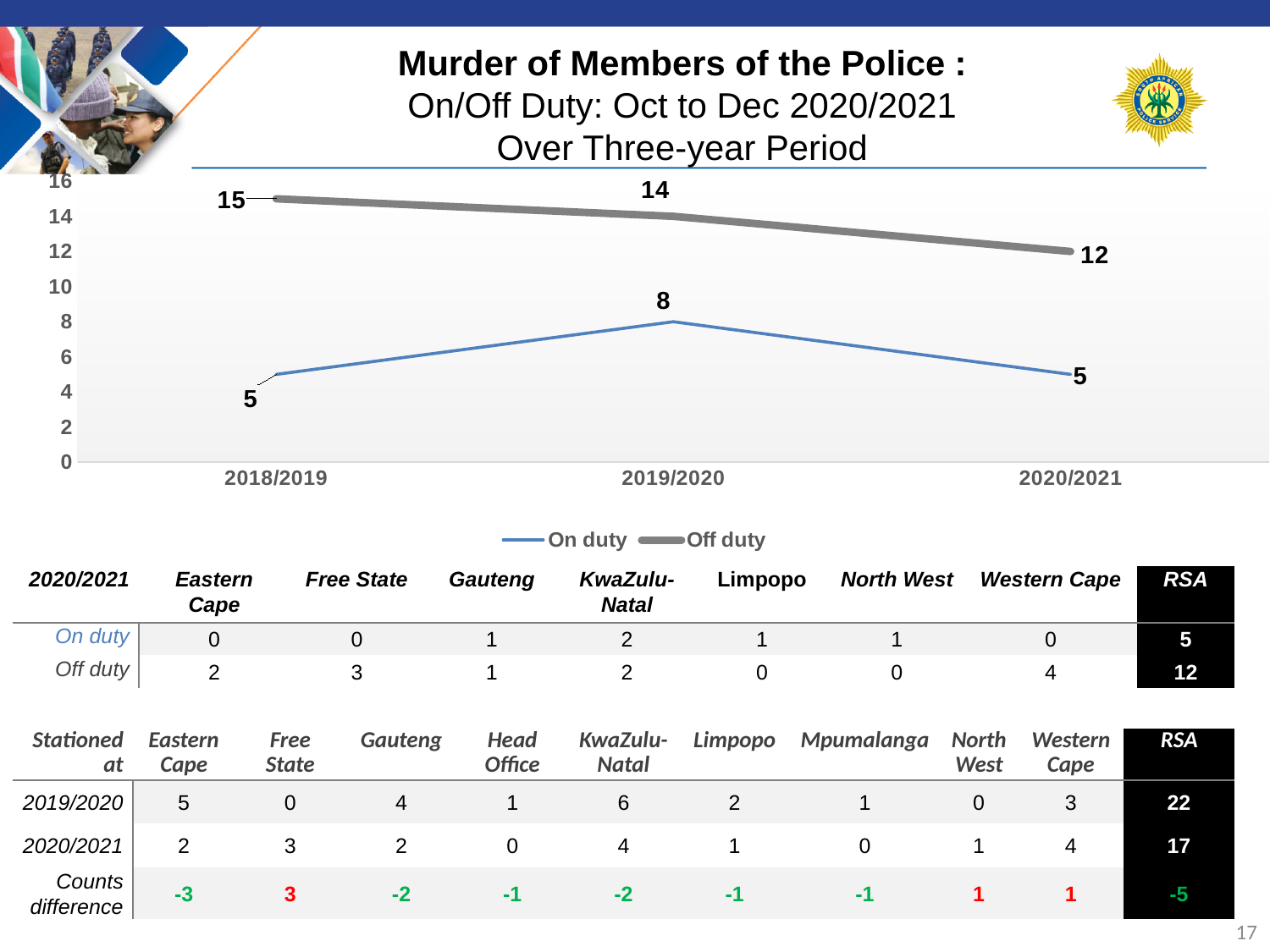
How many periods are plotted along the x axis of the chart? 3 In which period is the Off duty series lowest? 2020/2021 Which is larger in 2019/2020, the On duty value or the Off duty value? Off duty How many series does the chart legend list? 2 What type of chart is shown on the slide? line chart Does the Off duty series rise or fall from 2018/2019 to 2020/2021? fall Which series is drawn with the thick grey line in the chart? Off duty What is the difference between the Off duty and On duty values in 2018/2019? 10 In which period is the On duty series highest? 2019/2020 What is the Off duty value for 2020/2021? 12 What is the On duty value for 2019/2020? 8 What is the Off duty value for 2018/2019? 15